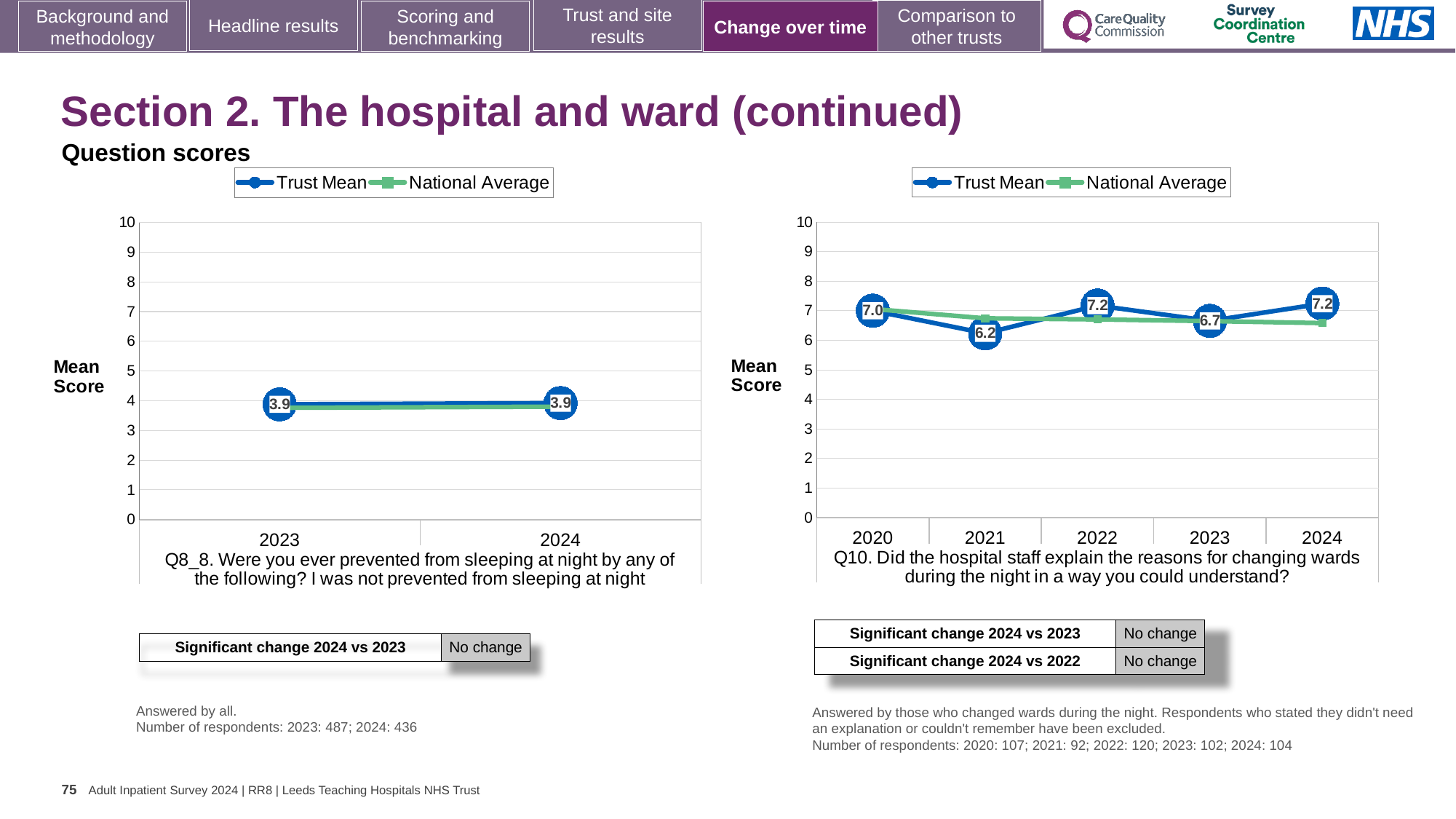
In the Q10 chart on the right, what is the Trust Mean score for 2021? 6.2 In the Q10 chart on the right, what is the Trust Mean score for 2023? 6.7 In the Q10 chart on the right, is the National Average value for 2024 greater or less than 7? less In the Q8_8 chart on the left, what is the Trust Mean score for 2023? 3.9 In the Q8_8 chart on the left, what is the Trust Mean score for 2024? 3.9 In the Q10 chart on the right, is the Trust Mean score higher in 2020 or in 2021? 2020 In the Q10 chart on the right, does the Trust Mean score rise or fall from 2020 to 2021? Fall In the Q10 chart on the right, what is the difference between the Trust Mean scores for 2022 and 2021? 1.0 How many years are plotted on the x axis of the Q10 chart on the right? 5 In the Q10 chart on the right, which year has the lowest Trust Mean score? 2021 What type of chart is the Q10 chart on the right? Line chart How many series does the legend of the Q8_8 chart on the left list? 2